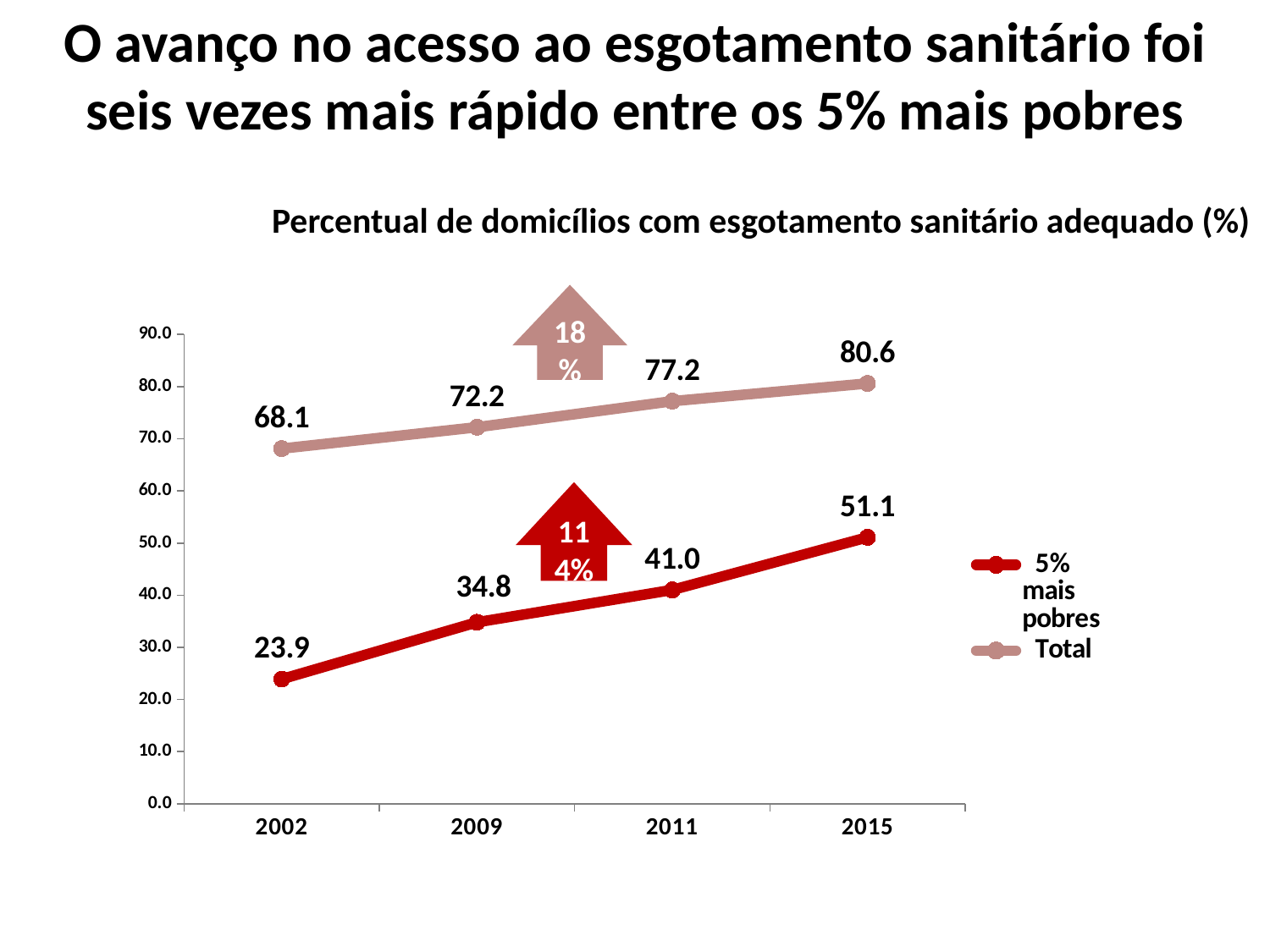
What is the difference between the 'Total' and '5% mais pobres' values in 2015? 29.5 By how much did the '5% mais pobres' value increase from 2002 to 2015? 27.2 What is the value for the 'Total' series in 2009? 72.2 What kind of chart is shown on the slide? Line chart What is the value for the 'Total' series in 2015? 80.6 How many series does the legend list? 2 In which year is the 'Total' series lowest? 2002 What is the value for the '5% mais pobres' series in 2011? 41.0 How many years are shown on the x axis? 4 In which year is the '5% mais pobres' series highest? 2015 What is the value for the '5% mais pobres' series in 2002? 23.9 Which series has the larger value in 2009, '5% mais pobres' or 'Total'? Total